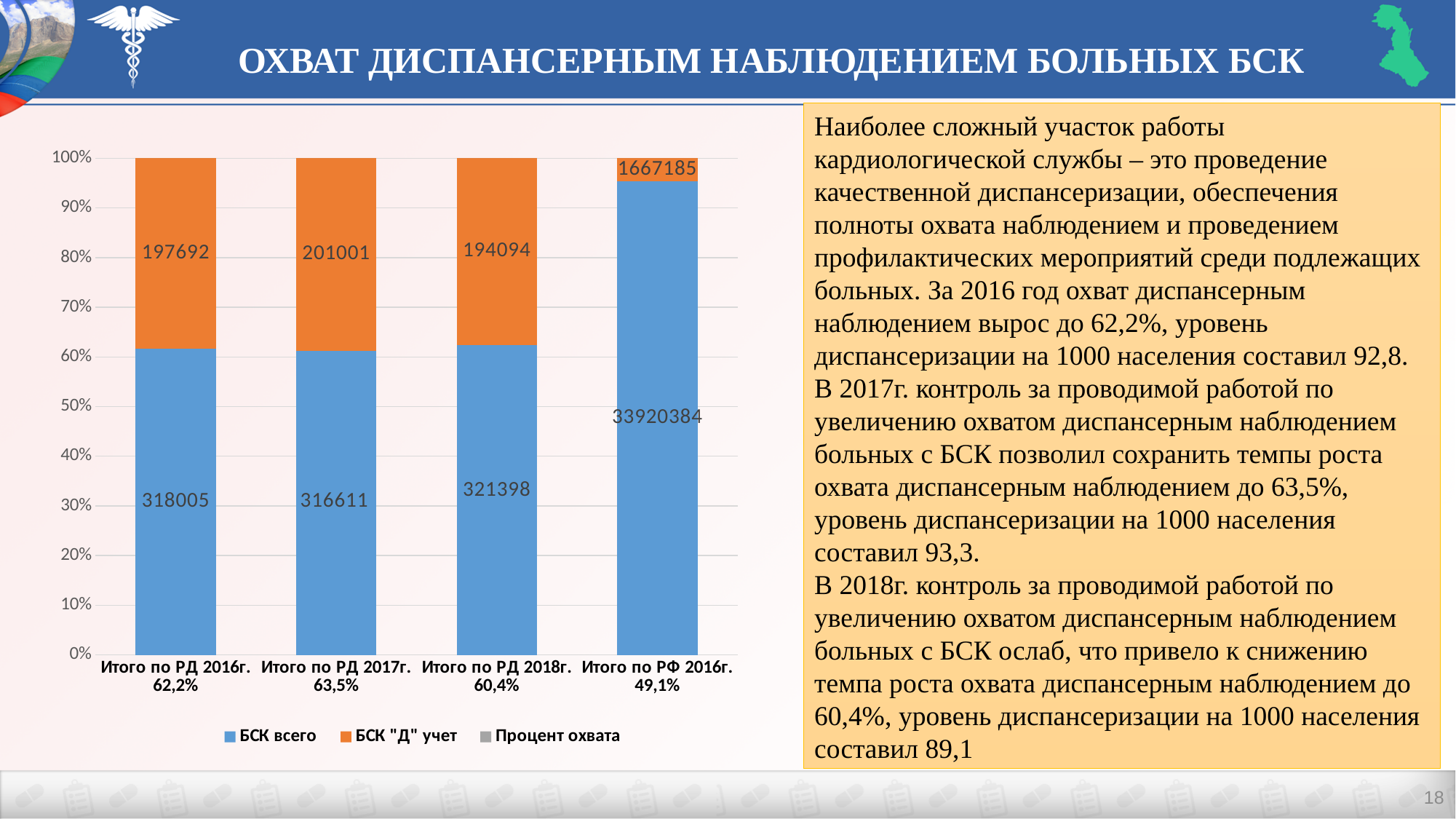
What is the difference between the БСК "Д" учет values for Итого по РД 2017г. and Итого по РД 2016г.? 3309 How many series does the legend list? 3 Which is larger: the БСК всего value for Итого по РД 2017г. or for Итого по РД 2018г.? Итого по РД 2018г. What value is printed on the БСК всего segment for Итого по РД 2016г. 62,2%? 318005 Which category has the highest printed БСК всего value? Итого по РФ 2016г. 49,1% Which category has the lowest printed БСК "Д" учет value? Итого по РД 2018г. 60,4% What value is printed on the БСК всего segment for Итого по РФ 2016г. 49,1%? 33920384 What value is printed on the БСК "Д" учет segment for Итого по РД 2018г. 60,4%? 194094 What value is printed on the БСК "Д" учет segment for Итого по РД 2017г. 63,5%? 201001 How many categories are shown on the x axis? 4 What kind of chart is shown on the slide? stacked bar chart Is the БСК всего share of the bar for Итого по РФ 2016г. greater or less than 90%? greater